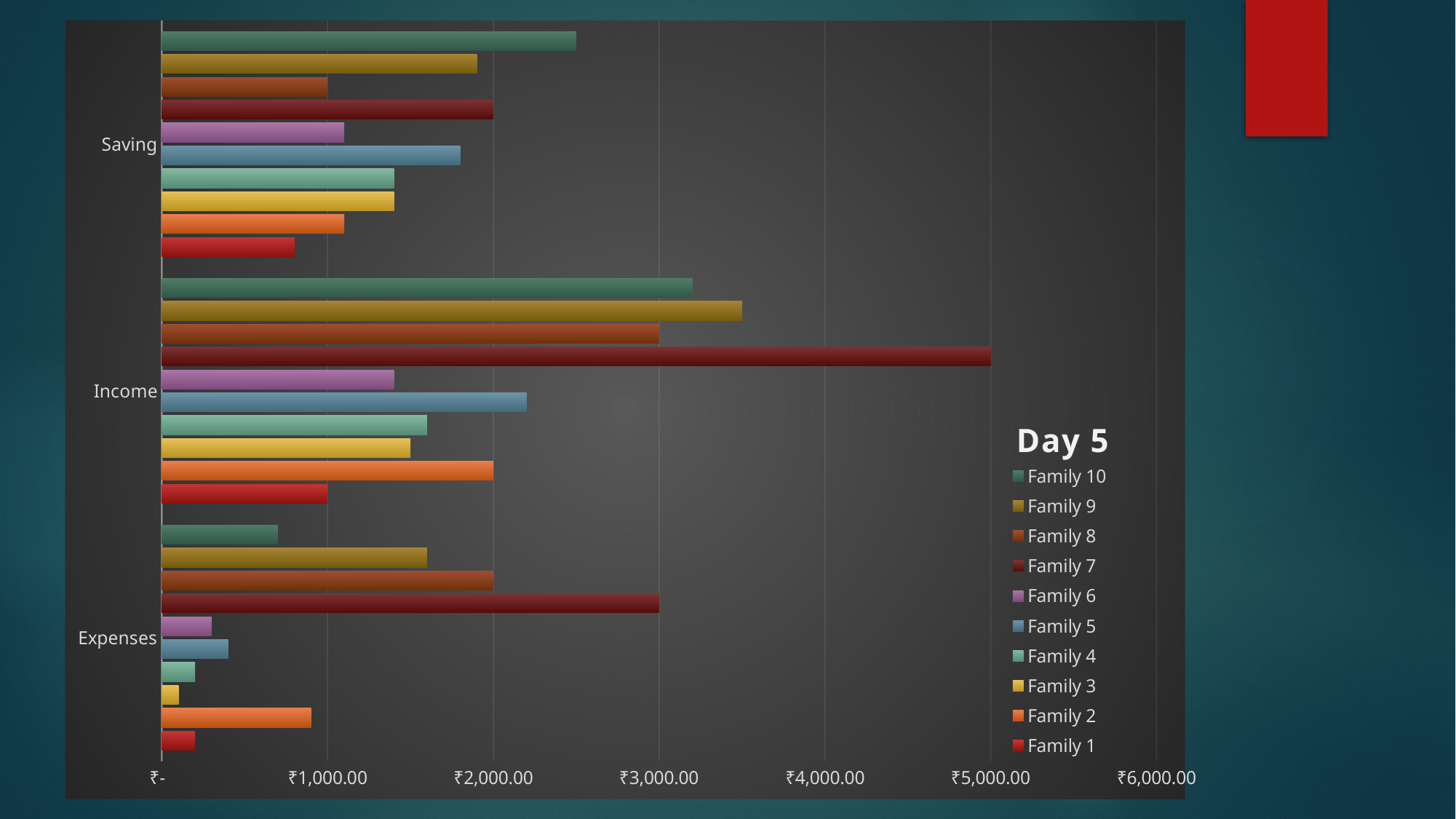
Which family has the highest Saving value? Family 10 How many categories are shown on the vertical axis? 3 Is the Saving value for Family 1 greater or less than ₹1,000.00? less Is the Income value for Family 9 greater or less than ₹3,000.00? greater For Expenses, which is larger: Family 2 or Family 1? Family 2 What is the title of the chart? Day 5 Which family has the highest Income value? Family 7 What kind of chart is shown on the slide? Bar chart How many series does the legend list? 10 What is the Expenses value for Family 7? ₹3,000.00 Which family has the lowest Expenses value? Family 3 What is the Income value for Family 7? ₹5,000.00